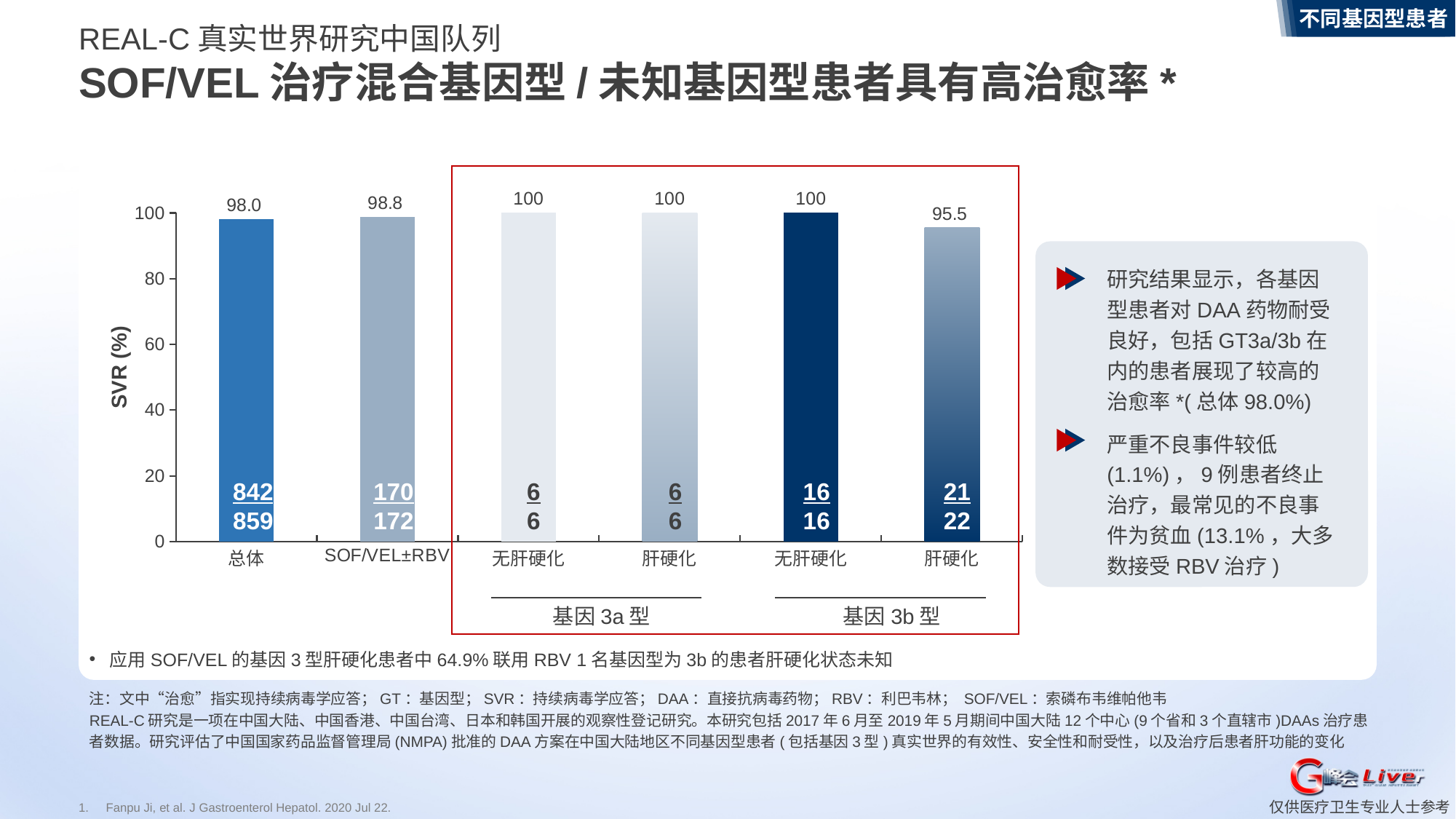
How many bars are shown in the chart? 6 What is the difference in SVR (%) between the 基因 3b 型 无肝硬化 bar and the 基因 3b 型 肝硬化 bar? 4.5 What is the SVR (%) value for the 肝硬化 bar in the 基因 3b 型 group? 95.5 What is the SVR (%) value for the SOF/VEL±RBV bar? 98.8 What fraction is printed inside the 总体 bar? 842/859 What is the difference in SVR (%) between the SOF/VEL±RBV bar and the 总体 bar? 0.8 What fraction is printed inside the 肝硬化 bar of the 基因 3b 型 group? 21/22 Which is larger, the SVR (%) for 总体 or for 基因 3b 型 肝硬化? 总体 What is the label of the y axis? SVR (%) What kind of chart is shown on the slide? Bar chart Which bar has the lowest SVR (%) value? 基因 3b 型 肝硬化 What is the SVR (%) value for the 总体 bar? 98.0